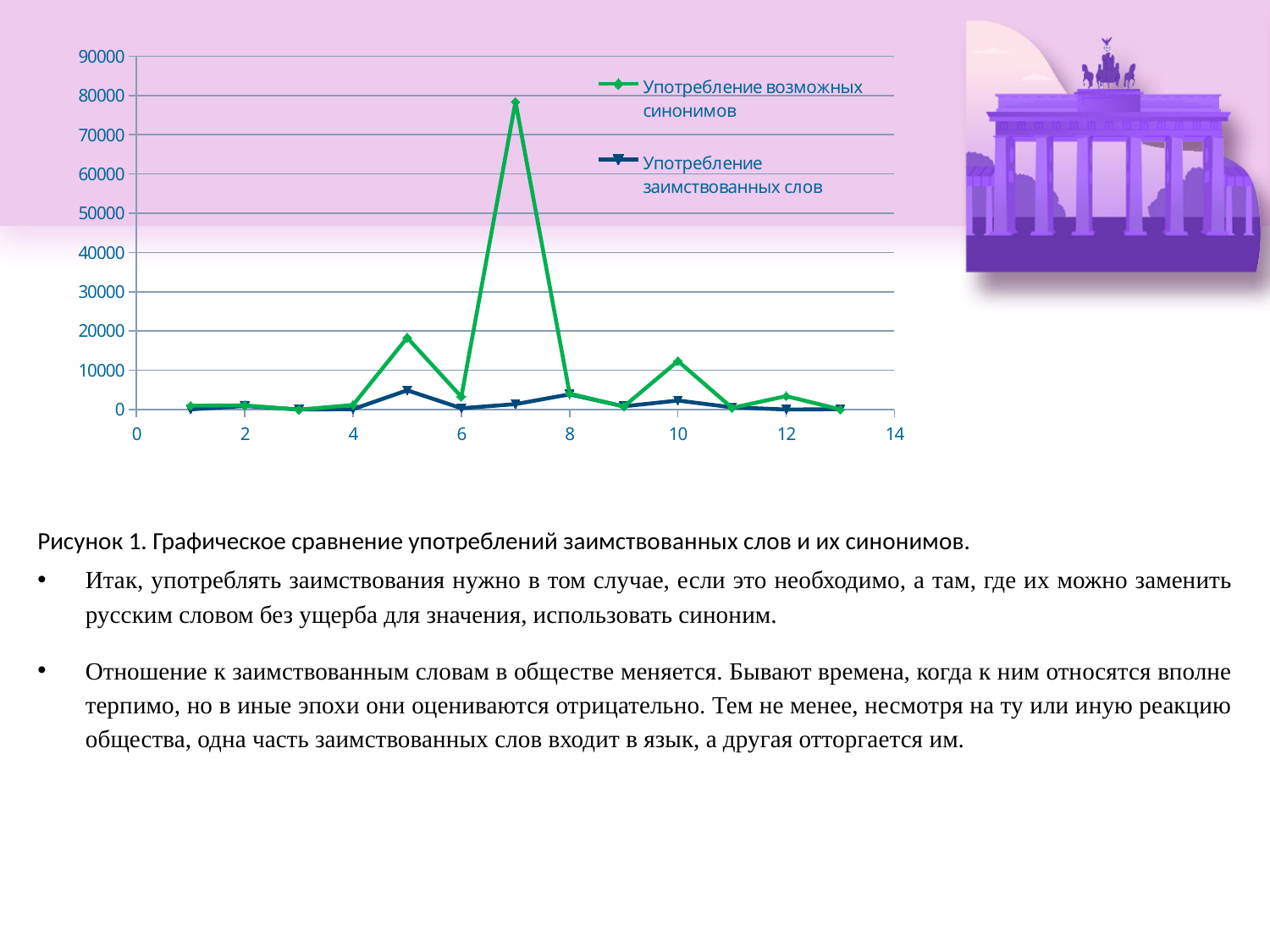
How many data points are plotted for each series? 13 Is the value of "Употребление возможных синонимов" at x = 7 greater or less than 70000? greater What are the two series named in the legend? Употребление возможных синонимов; Употребление заимствованных слов What kind of chart is shown on the slide? line chart Is the value of "Употребление возможных синонимов" at x = 5 greater or less than 20000? less How many series does the legend list? 2 Which colour is used for the series "Употребление возможных синонимов"? green Is the value of "Употребление возможных синонимов" at x = 5 greater or less than 10000? greater At which x value does the series "Употребление возможных синонимов" reach its highest point? 7 At x = 7, which series has the larger value: "Употребление возможных синонимов" or "Употребление заимствованных слов"? Употребление возможных синонимов